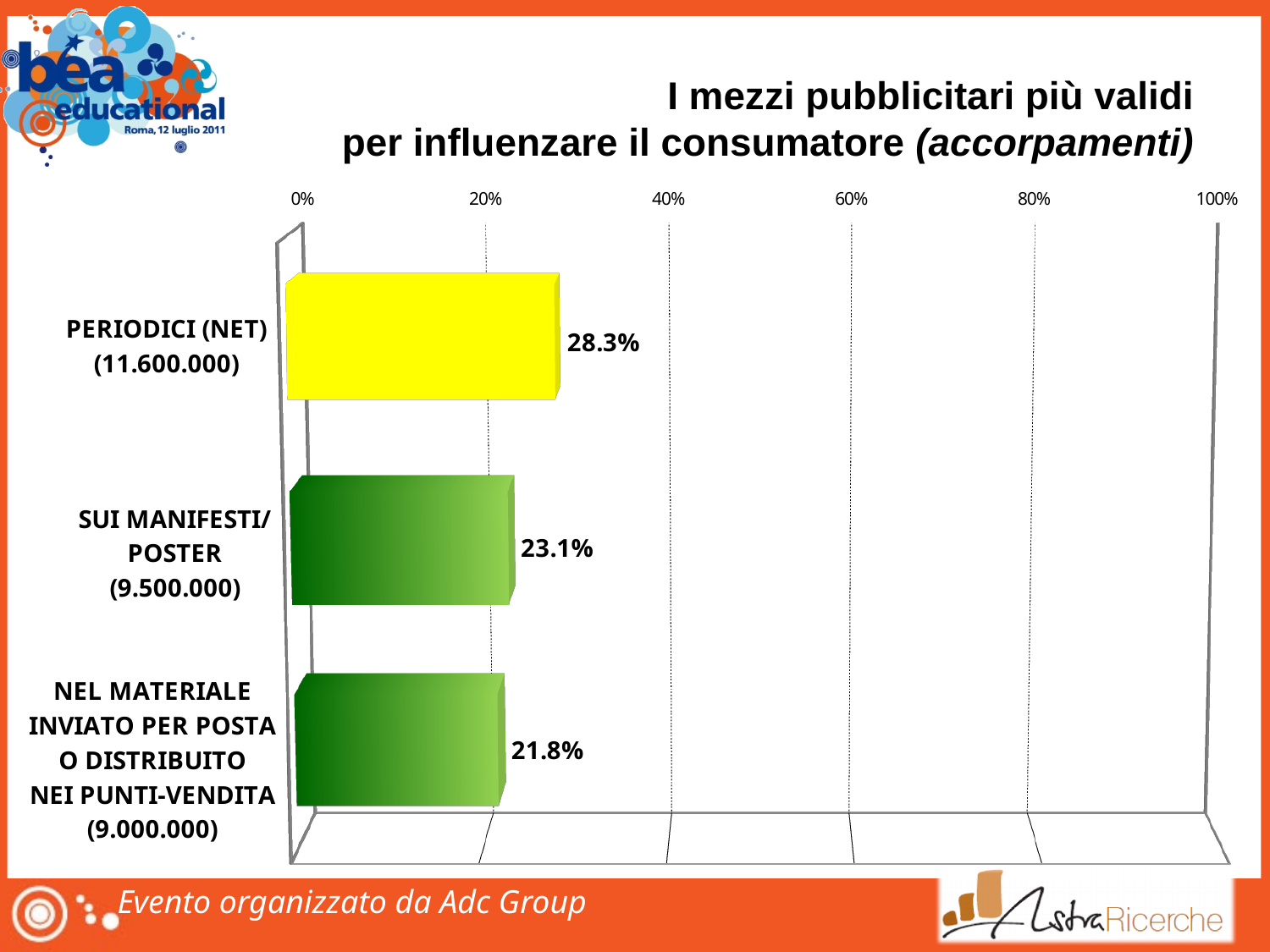
How many categories are shown in the chart? 3 What kind of chart is shown on the slide? bar chart What colour is the bar for PERIODICI (NET)? yellow Which is larger, the value for SUI MANIFESTI/POSTER or the value for NEL MATERIALE INVIATO PER POSTA O DISTRIBUITO NEI PUNTI-VENDITA? SUI MANIFESTI/POSTER Is the value for PERIODICI (NET) greater or less than 20%? greater What is the value for SUI MANIFESTI/POSTER? 23.1% What is the difference between the values for PERIODICI (NET) and SUI MANIFESTI/POSTER? 5.2% Which category has the lowest value? NEL MATERIALE INVIATO PER POSTA O DISTRIBUITO NEI PUNTI-VENDITA Which category has the highest value? PERIODICI (NET) Is the value for NEL MATERIALE INVIATO PER POSTA O DISTRIBUITO NEI PUNTI-VENDITA greater or less than 40%? less What is the value for NEL MATERIALE INVIATO PER POSTA O DISTRIBUITO NEI PUNTI-VENDITA? 21.8% What is the value for PERIODICI (NET)? 28.3%